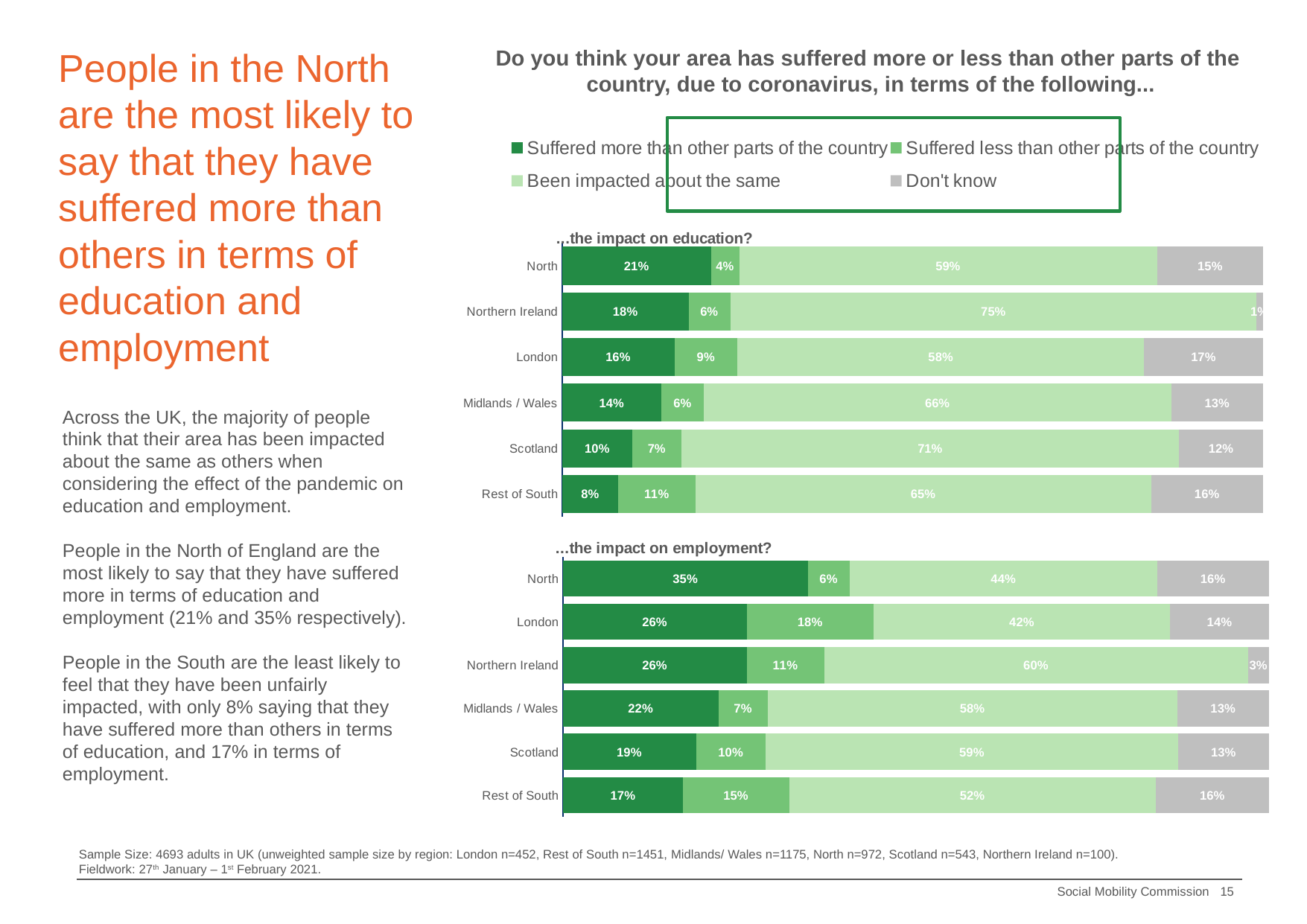
What kind of chart is used to show the impact on education? Stacked bar chart How many series does the legend list? 4 In the '…the impact on education?' chart, what percentage of people in Scotland said they had been impacted about the same? 71% In the '…the impact on education?' chart, which is larger: the 'Don't know' value for London or for Scotland? London How many regions are shown in the '…the impact on employment?' chart? 6 Which legend entry is shown in the darkest green colour? Suffered more than other parts of the country In the '…the impact on education?' chart, what percentage of people in the North said their area suffered more than other parts of the country? 21% In the '…the impact on employment?' chart, what is the 'Don't know' value for Northern Ireland? 3% In the '…the impact on education?' chart, which region has the highest share saying they have been impacted about the same? Northern Ireland In the '…the impact on employment?' chart, which region has the lowest share saying they suffered more than other parts of the country? Rest of South In the '…the impact on employment?' chart, what is the difference between the North's and the Rest of South's 'Suffered more than other parts of the country' values? 18% In the '…the impact on employment?' chart, what percentage of people in London said their area suffered less than other parts of the country? 18%